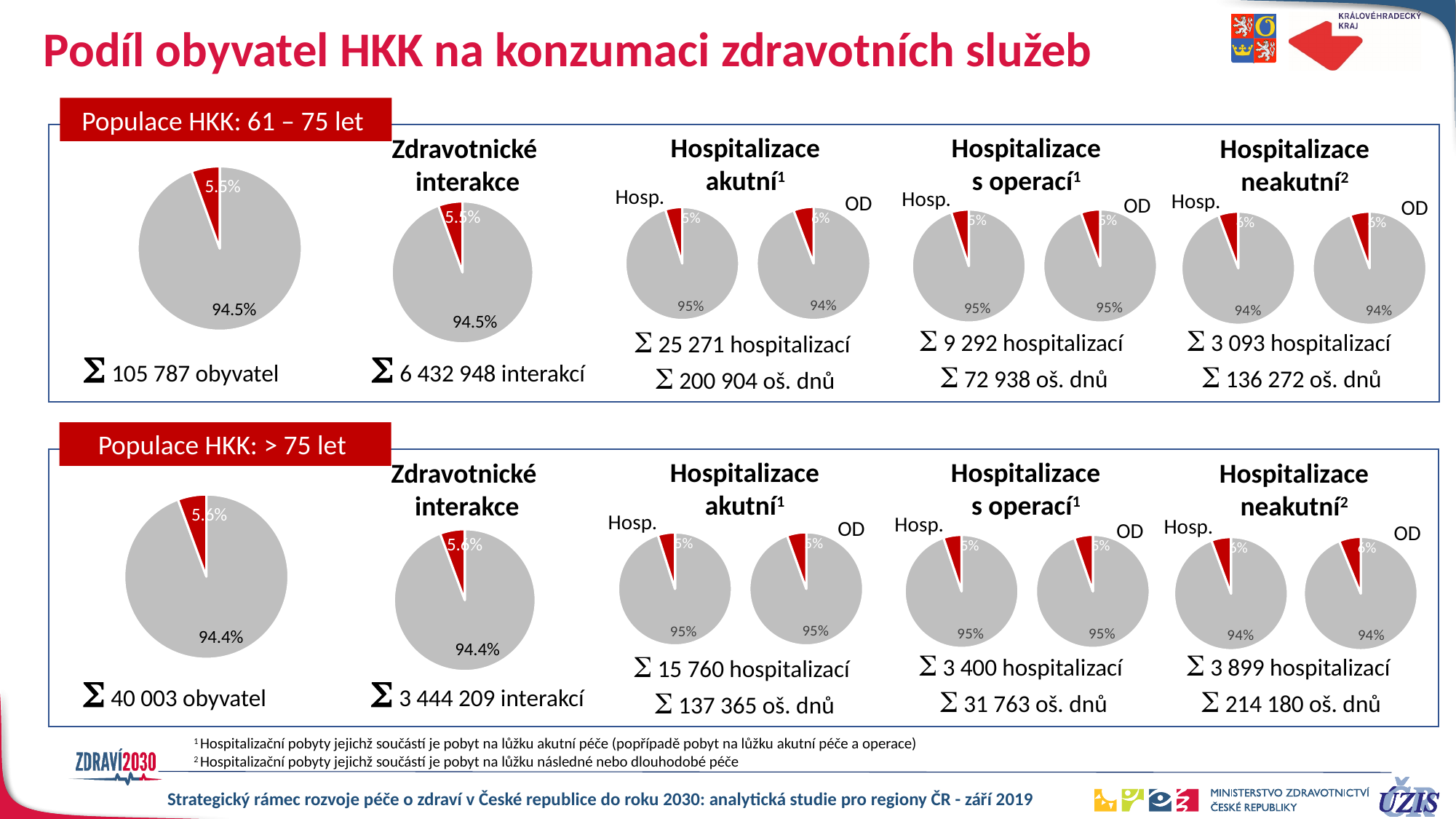
In the 'Hospitalizace s operací' OD pie chart for the > 75 let population, what share does the grey slice represent? 95% In the 'Zdravotnické interakce' pie chart for the 61 – 75 let population, what share does the grey slice represent? 94.5% In the population pie chart for 'Populace HKK: 61 – 75 let', what is the difference in percentage points between the grey slice and the red slice? 89 percentage points In the population pie chart for 'Populace HKK: 61 – 75 let', what share does the red slice represent? 5.5% What kind of charts are shown on the slide? Pie charts In the population pie chart for 'Populace HKK: > 75 let', which slice is larger, the grey one or the red one? The grey one How many slices does the population pie chart for 'Populace HKK: 61 – 75 let' have? 2